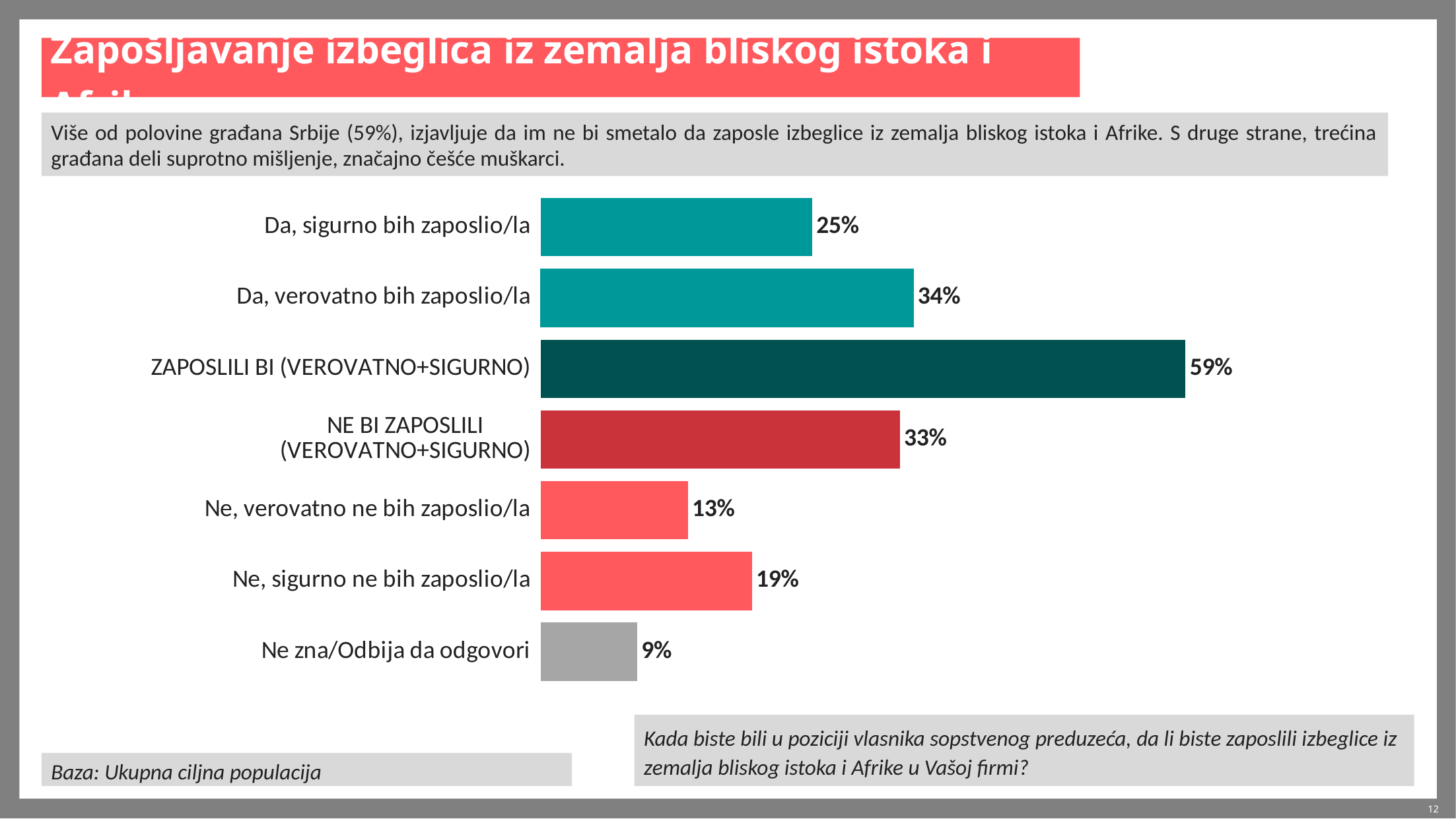
What kind of chart is shown on the slide? Bar chart How many categories are shown in the chart? 7 What is the difference between "ZAPOSLILI BI (VEROVATNO+SIGURNO)" and "NE BI ZAPOSLILI (VEROVATNO+SIGURNO)"? 26% What is the difference between "Ne, sigurno ne bih zaposlio/la" and "Ne, verovatno ne bih zaposlio/la"? 6% What is the value for "Ne zna/Odbija da odgovori"? 9% What colour is the bar for "Ne zna/Odbija da odgovori"? Grey What is the value for "NE BI ZAPOSLILI (VEROVATNO+SIGURNO)"? 33% What is the value for "Da, sigurno bih zaposlio/la"? 25% Which category has the highest value? ZAPOSLILI BI (VEROVATNO+SIGURNO) Which category has the lowest value? Ne zna/Odbija da odgovori Which is larger: "Da, verovatno bih zaposlio/la" or "Da, sigurno bih zaposlio/la"? Da, verovatno bih zaposlio/la What is the value for "Da, verovatno bih zaposlio/la"? 34%